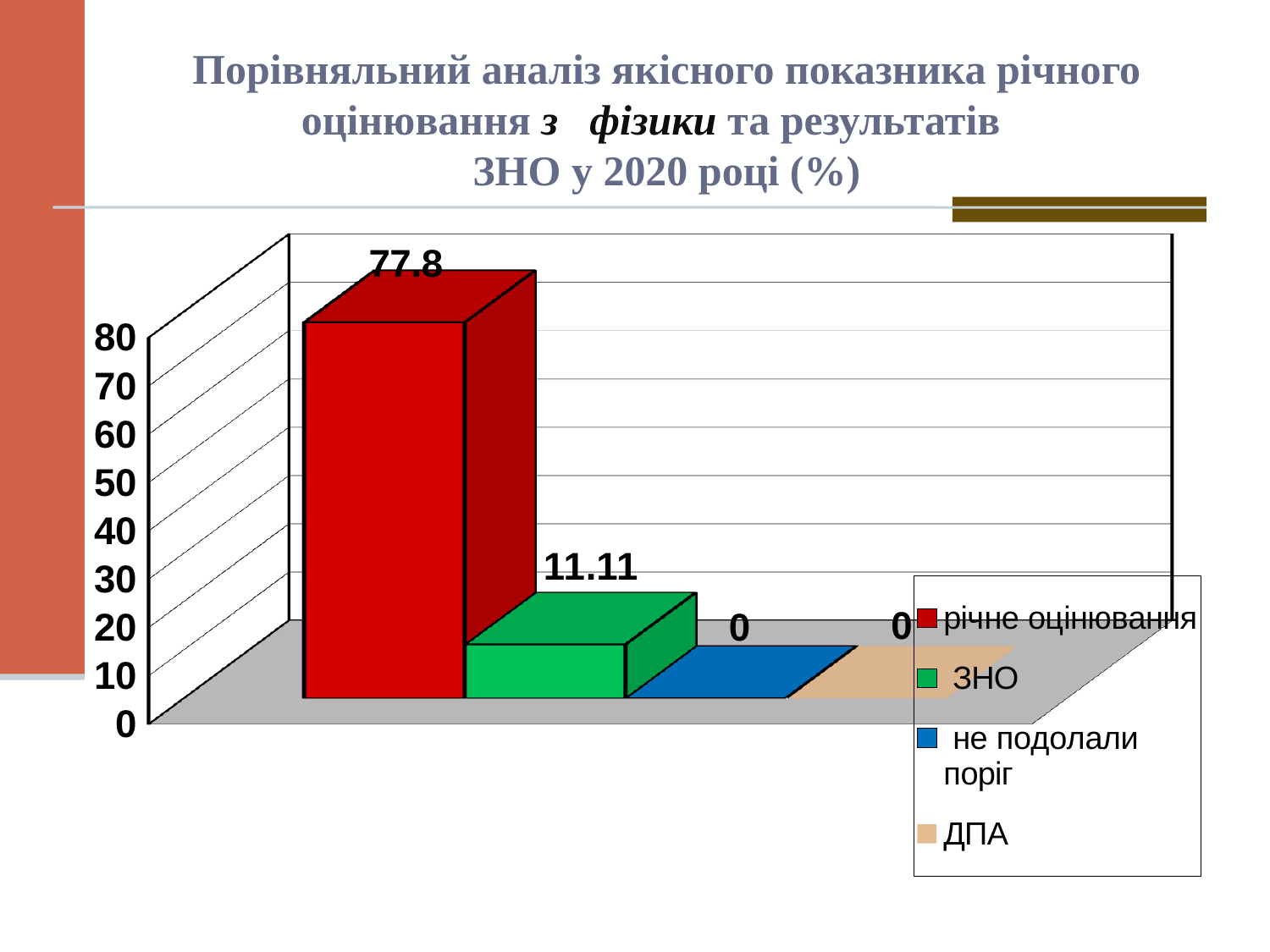
What kind of chart is shown on the slide? bar chart How many series does the legend list? 4 Is the value for ЗНО greater or less than 20? less What colour is the bar for ЗНО? green What is the value for не подолали поріг? 0 What is the value for ДПА? 0 Which is larger, the value for річне оцінювання or the value for ЗНО? річне оцінювання Is the value for річне оцінювання greater or less than 70? greater What is the value for річне оцінювання? 77.8 What is the value for ЗНО? 11.11 What is the difference between the values for річне оцінювання and ЗНО? 66.69 Which series has the highest value? річне оцінювання